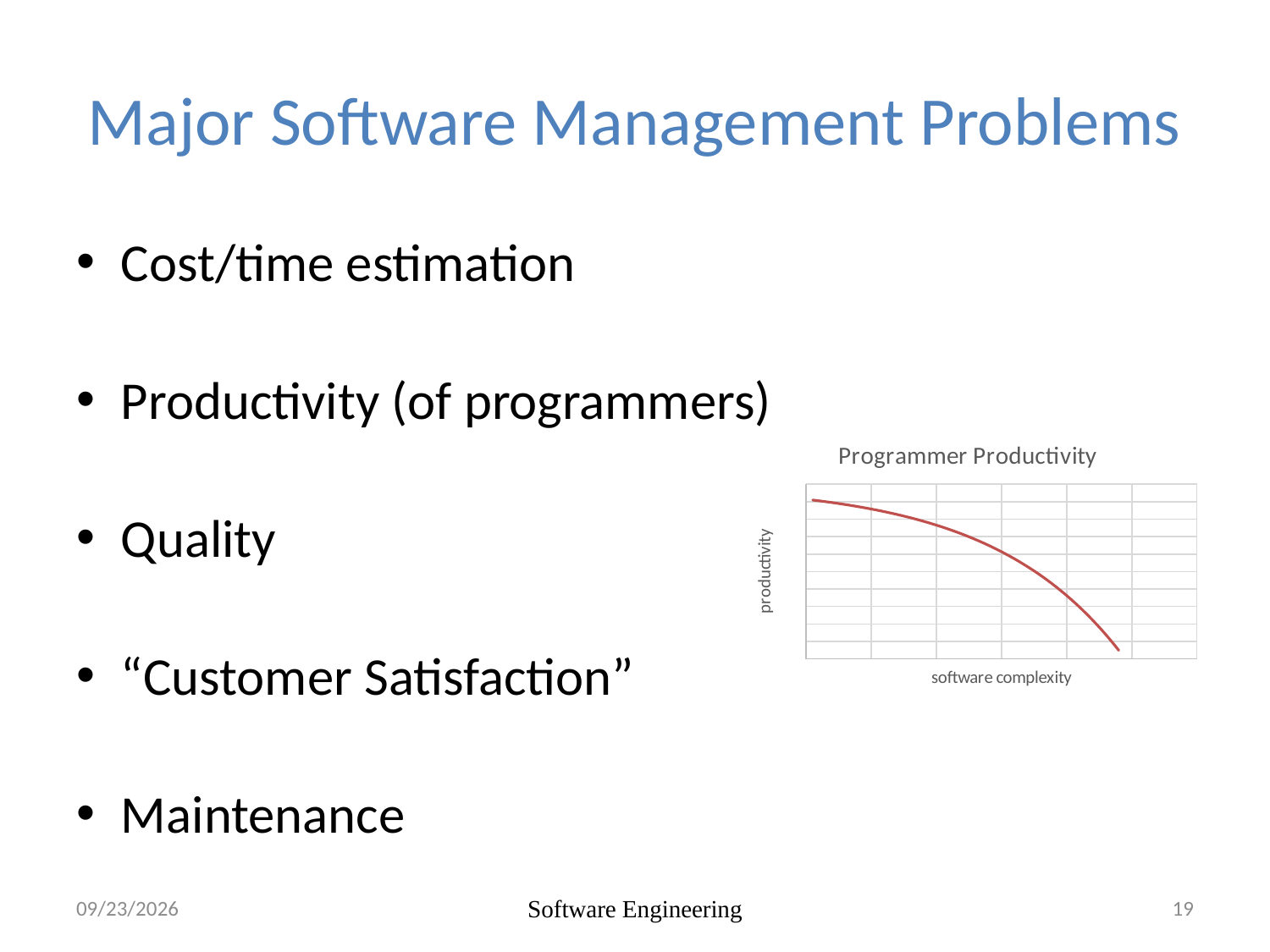
What is the label of the horizontal axis of the chart? software complexity What is the title of the chart on the slide? Programmer Productivity Does productivity rise or fall as software complexity increases along the x axis? fall What kind of chart is shown on the slide? line chart Is the line in the chart increasing or decreasing from left to right? decreasing